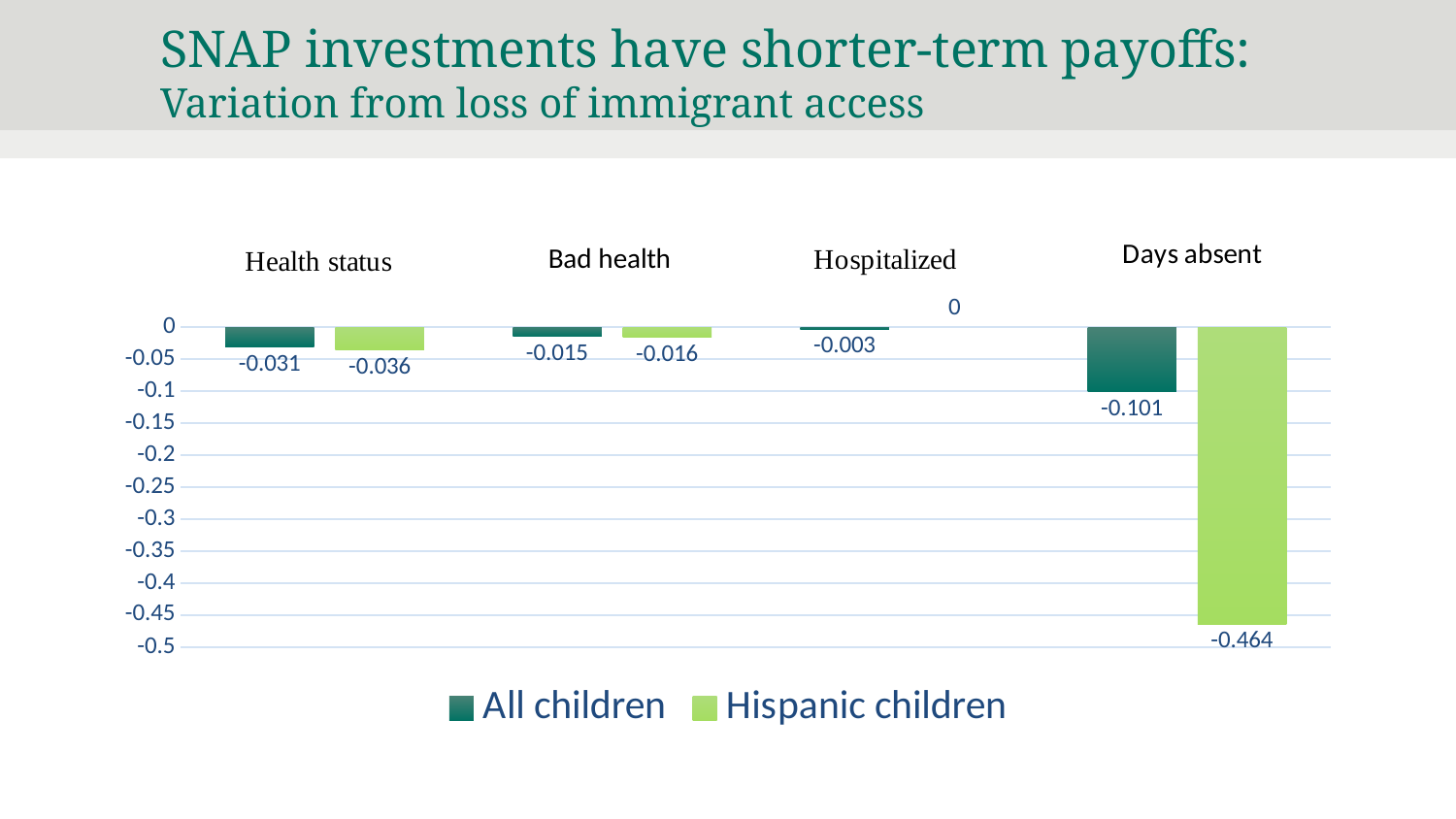
In the Health status category, which series has the more negative value, All children or Hispanic children? Hispanic children What kind of chart is shown on the slide? Bar chart What is the difference between the All children and Hispanic children values in the Days absent category? 0.363 What is the value for Hispanic children in the Hospitalized category? 0 Which category has the lowest (most negative) value for Hispanic children? Days absent What is the value for All children in the Days absent category? -0.101 How many series does the legend list? 2 How many categories are shown on the chart? 4 Which category has the lowest (most negative) value for All children? Days absent What is the value for All children in the Health status category? -0.031 Is the value for Hispanic children in the Days absent category greater or less than -0.4? less What is the value for Hispanic children in the Days absent category? -0.464